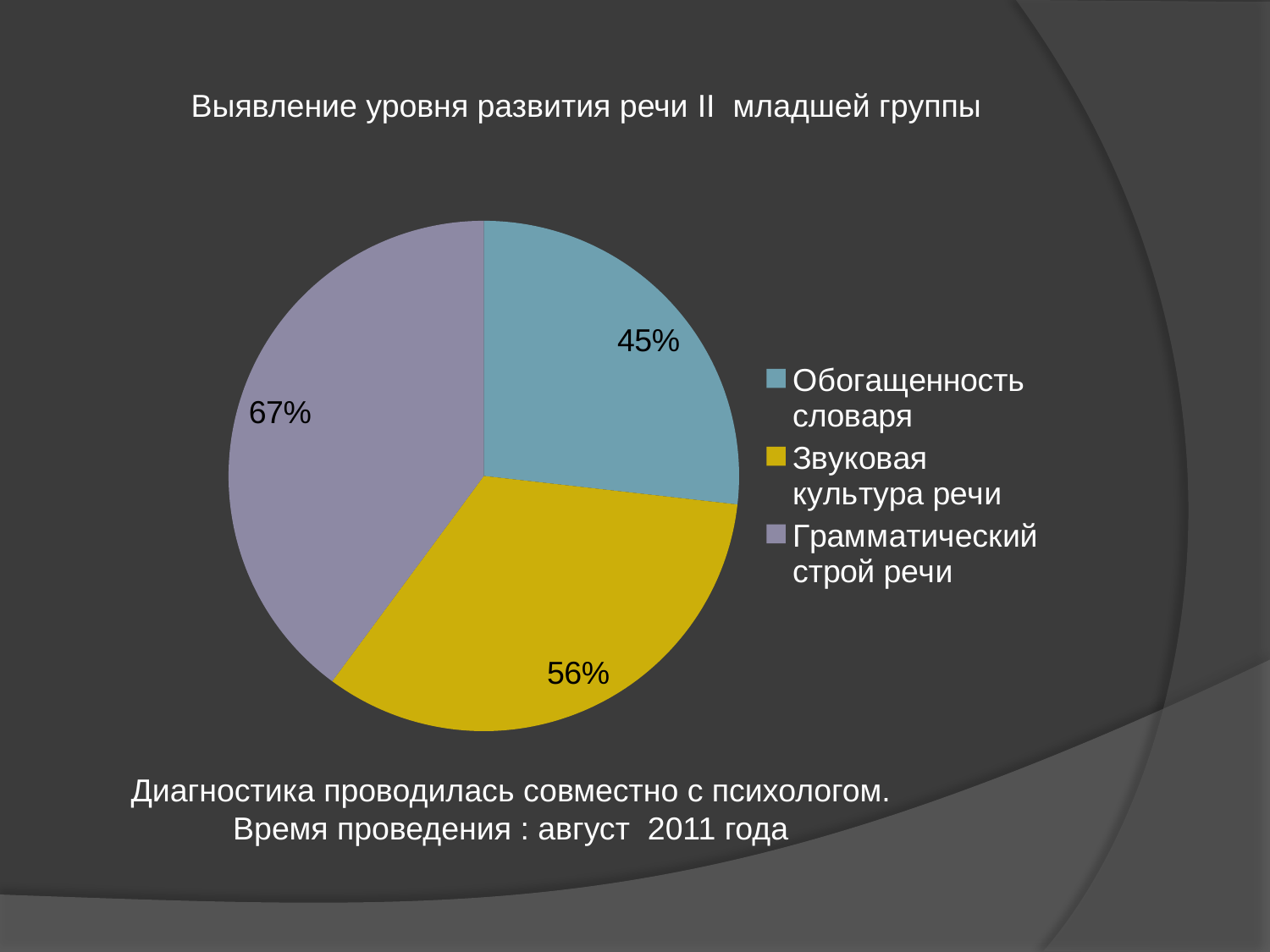
What is the value shown for Звуковая культура речи? 56% How many slices does the pie chart have? 3 What is the title of the chart? Выявление уровня развития речи II младшей группы Which category has the highest value? Грамматический строй речи What type of chart is shown on the slide? pie chart What is the value shown for Обогащенность словаря? 45% Which is larger, the value for Звуковая культура речи or the value for Обогащенность словаря? Звуковая культура речи What is the value shown for Грамматический строй речи? 67% Which category has the lowest value? Обогащенность словаря What is the difference between the values for Грамматический строй речи and Обогащенность словаря? 22% What is the difference between the values for Звуковая культура речи and Обогащенность словаря? 11% What colour is the slice for Звуковая культура речи? yellow